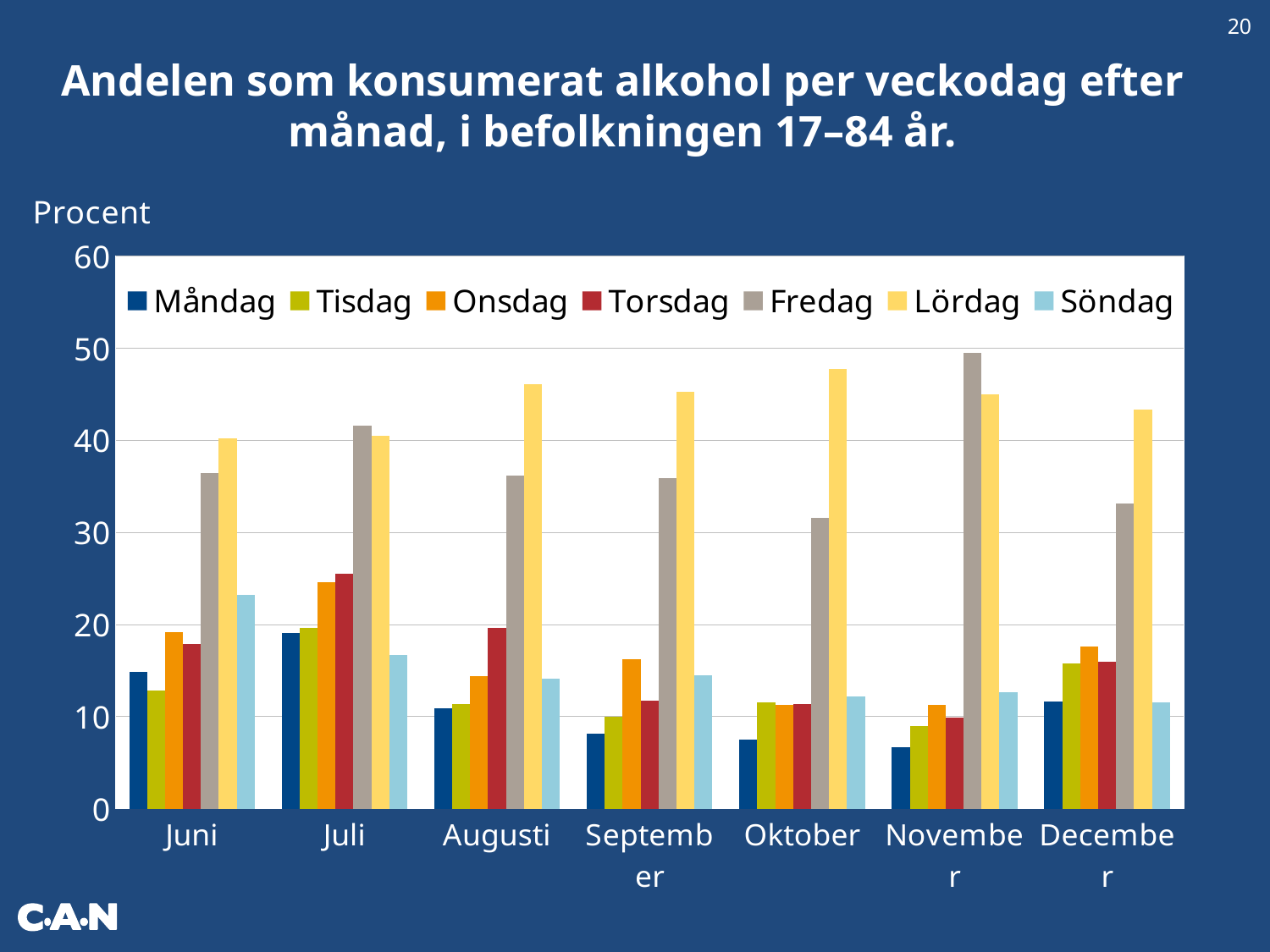
In Oktober, which is larger: Fredag or Lördag? Lördag Is the value for Måndag in November greater or less than 10? less In which month is the Fredag value highest? November What is the label on the y axis of the chart? Procent Is the value for Söndag in Juni greater or less than 20? greater How many months are shown on the x axis? 7 Which weekday has the highest value in Augusti? Lördag In November, which is larger: Fredag or Lördag? Fredag How many series does the legend list? 7 Which weekday has the lowest value in November? Måndag Is the value for Fredag in November greater or less than 40? greater What kind of chart is shown on the slide? bar chart